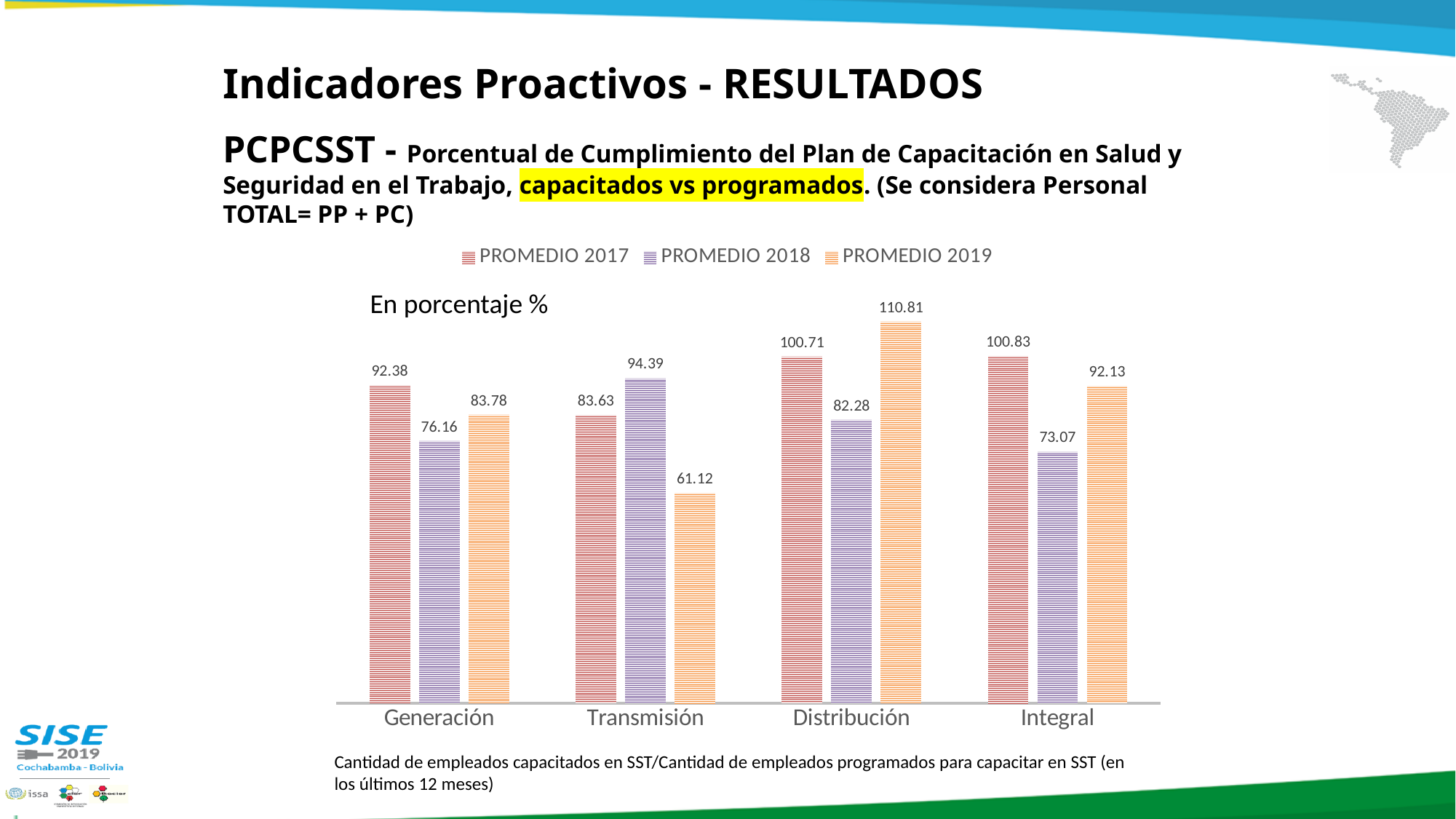
How many categories are shown on the x axis? 4 What is the PROMEDIO 2017 value for Transmisión? 83.63 What is the PROMEDIO 2019 value for Distribución? 110.81 Which is larger for Generación: PROMEDIO 2017 or PROMEDIO 2019? PROMEDIO 2017 Which category has the lowest PROMEDIO 2018 value? Integral Which category has the highest PROMEDIO 2019 value? Distribución What is the difference between the PROMEDIO 2018 and PROMEDIO 2019 values for Transmisión? 33.27 What is the PROMEDIO 2019 value for Integral? 92.13 What kind of chart is shown on the slide? Bar chart Which category has the lowest PROMEDIO 2019 value? Transmisión How many series does the legend list? 3 What is the PROMEDIO 2018 value for Generación? 76.16